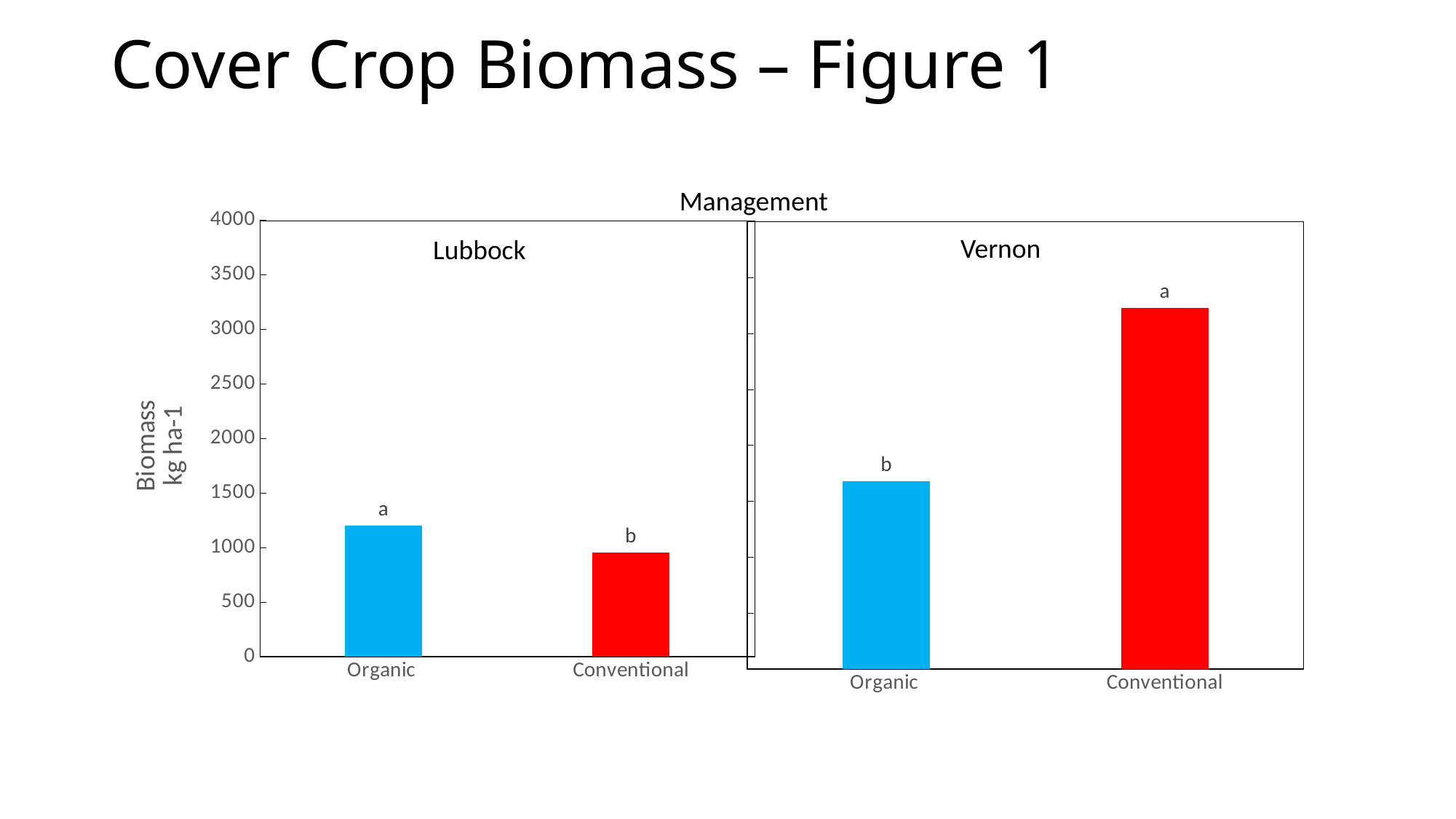
What is the label on the vertical axis of the charts? Biomass kg ha-1 In the Lubbock chart, which management category has the higher biomass? Organic In the Vernon chart, which management category has the lower biomass? Organic In the Vernon chart, which is larger, Organic or Conventional? Conventional In the Vernon chart, is the value for Conventional greater or less than 3500? less In the Lubbock chart, is the value for Conventional greater or less than 1500? less What colour are the Organic bars in both charts? blue In the Lubbock chart, is the value for Organic greater or less than 1000? greater What kind of chart is the Lubbock chart? bar chart How many management categories are shown in the Lubbock chart? 2